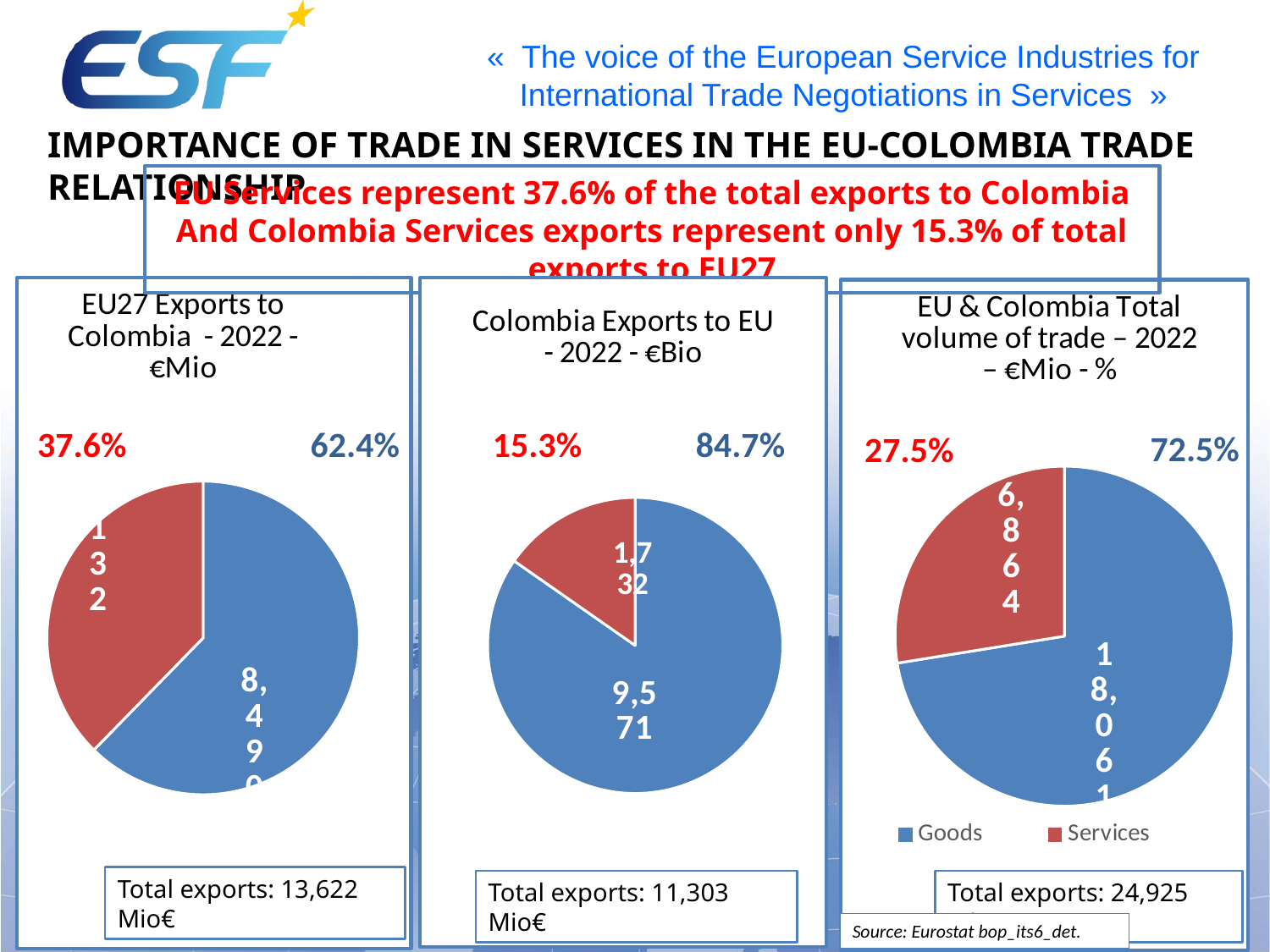
Which colour represents Services in the pie charts? Red In the 'EU27 Exports to Colombia - 2022' chart, which is larger, Goods or Services? Goods In the 'EU & Colombia Total volume of trade - 2022' chart, which category is the largest? Goods In the 'Colombia Exports to EU - 2022' chart, what is the difference between the Goods value and the Services value? 7,839 In the 'EU27 Exports to Colombia - 2022' chart, what share of the pie is Goods? 62.4% In the 'Colombia Exports to EU - 2022' chart, what share of the pie is Services? 15.3% What kind of charts are shown on the slide? Pie charts In the 'EU27 Exports to Colombia - 2022' chart, what share of the pie is Services? 37.6% In the 'Colombia Exports to EU - 2022' chart, what is the value for Services? 1,732 In the 'Colombia Exports to EU - 2022' chart, what is the value for Goods? 9,571 How many categories does the legend list for the 'EU & Colombia Total volume of trade - 2022' chart? 2